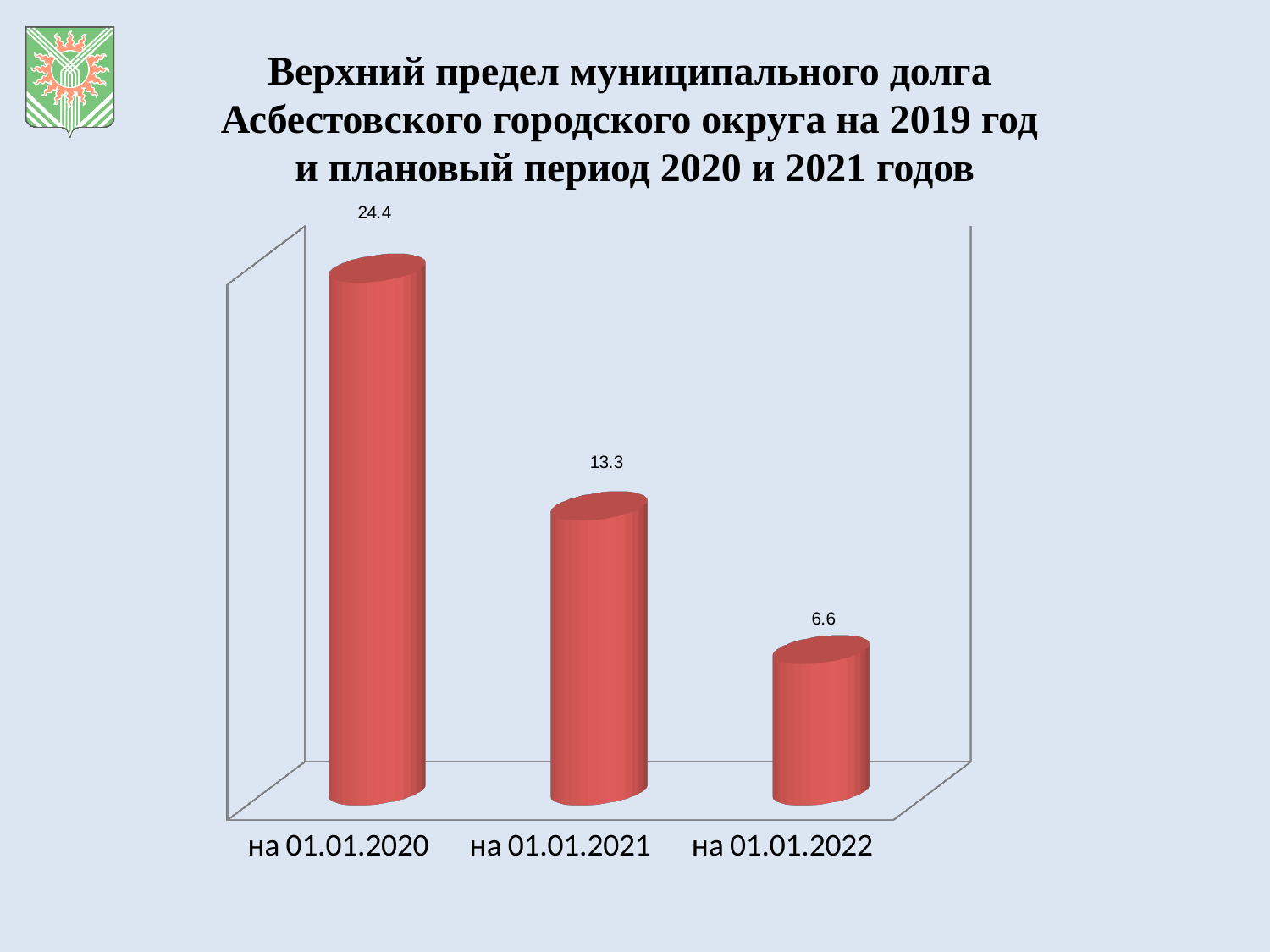
What is the value for на 01.01.2021? 13.3 What is the value for на 01.01.2022? 6.6 What colour are the bars on the chart? red What is the difference between the values for на 01.01.2020 and на 01.01.2021? 11.1 What kind of chart is shown on the slide? bar chart How many categories are shown on the chart? 3 Which category has the highest value? на 01.01.2020 Which is larger, the value for на 01.01.2021 or the value for на 01.01.2022? на 01.01.2021 What is the value for на 01.01.2020? 24.4 Do the values rise or fall from left to right along the x axis? fall Which category has the lowest value? на 01.01.2022 What is the difference between the values for на 01.01.2021 and на 01.01.2022? 6.7